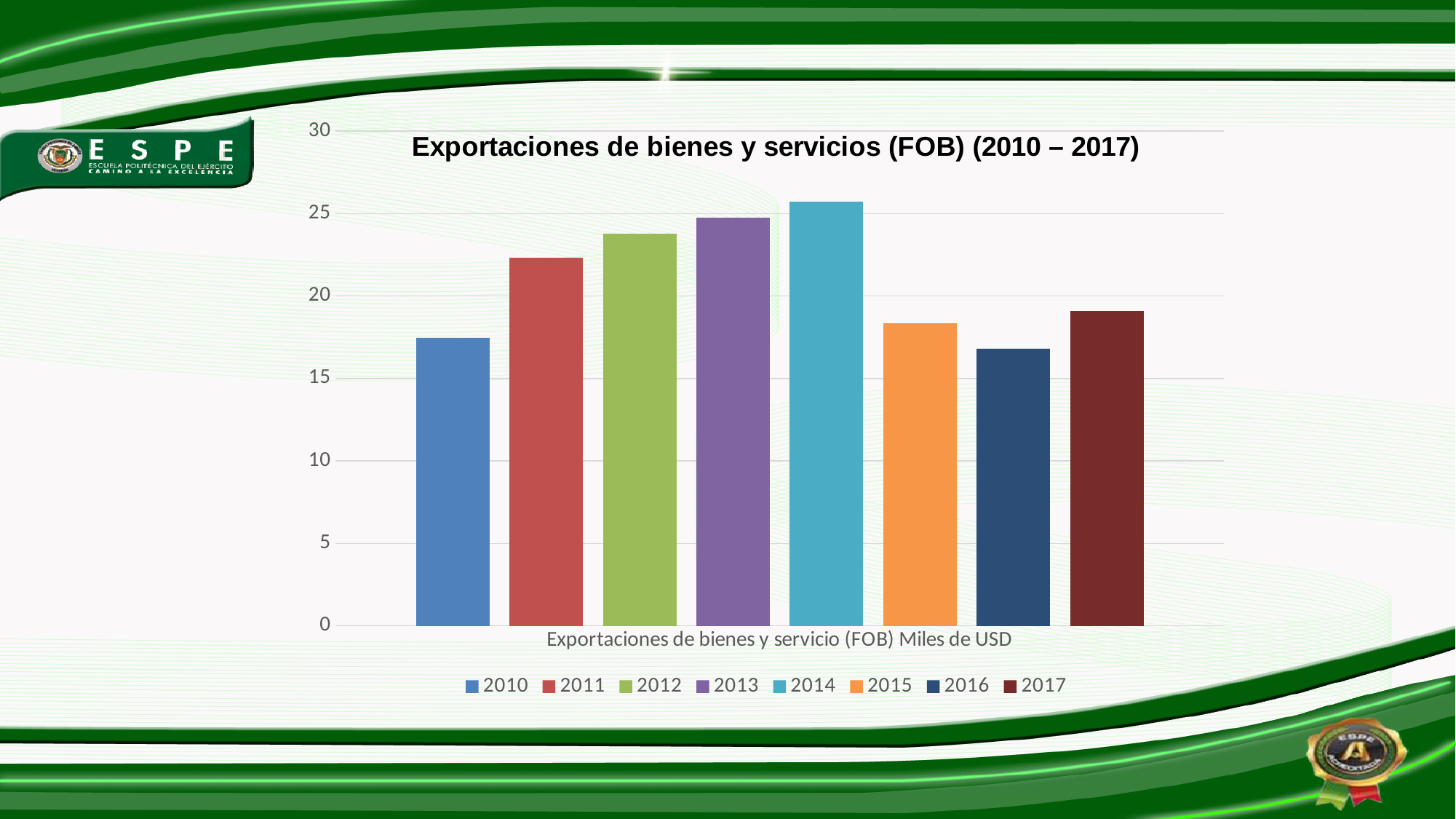
Is the value for 2010 greater or less than 20? less Which year has the lowest value in the chart? 2016 Is the value for 2015 greater or less than 15? greater What is the title of the chart? Exportaciones de bienes y servicios (FOB) (2010 – 2017) How many series does the legend list? 8 Which is larger, the value for 2015 or the value for 2016? 2015 Do the values rise or fall from 2010 to 2014? rise Is the value for 2017 greater or less than 20? less Which is larger, the value for 2013 or the value for 2011? 2013 Which year has the highest value in the chart? 2014 What kind of chart is shown on the slide? bar chart